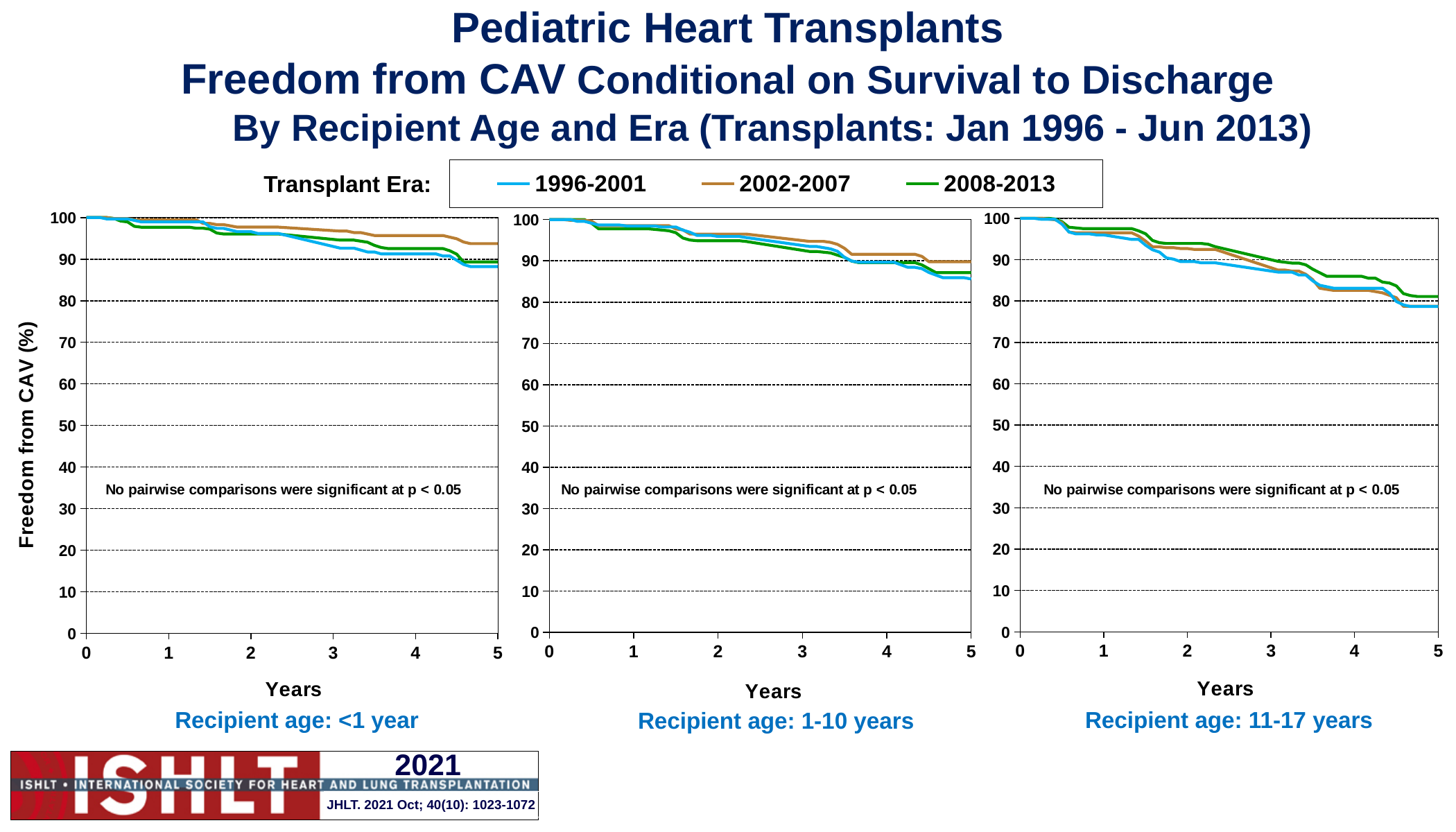
What is the label on the y-axis of the charts? Freedom from CAV (%) In the 'Recipient age: 1-10 years' chart, which transplant era has the highest freedom from CAV at 5 years? 2002-2007 In the 'Recipient age: 11-17 years' chart, is the freedom from CAV for the 1996-2001 era at 5 years greater or less than 90? less What kind of chart is used in each of the three panels on the slide? Line chart In the 'Recipient age: 11-17 years' chart, which transplant era has the highest freedom from CAV at 5 years? 2008-2013 In the 'Recipient age: 11-17 years' chart, at 2 years, is freedom from CAV higher for the 2008-2013 era or the 1996-2001 era? 2008-2013 In the 'Recipient age: <1 year' chart, does freedom from CAV rise or fall as years since transplant increase? Fall How many transplant eras does the legend list? 3 In the 'Recipient age: 1-10 years' chart, is the freedom from CAV for the 2002-2007 era at 5 years greater or less than 80? greater In the 'Recipient age: <1 year' chart, is the freedom from CAV for the 1996-2001 era at 5 years greater or less than 90? less In the 'Recipient age: <1 year' chart, which transplant era has the highest freedom from CAV at 5 years? 2002-2007 How many chart panels are shown on the slide? 3